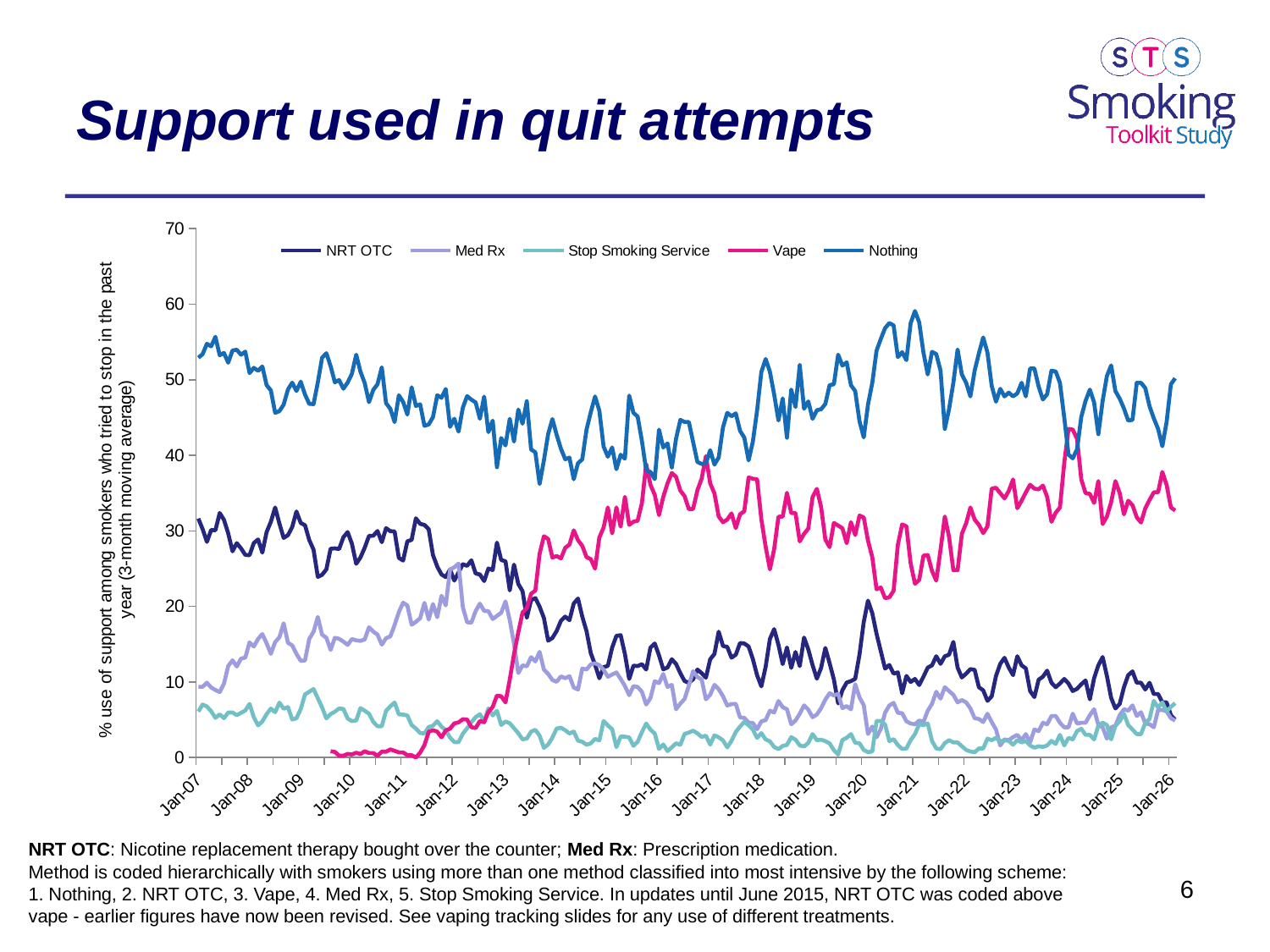
Which series has the lowest value around Jan-20? Stop Smoking Service Is the value for Vape at Jan-10 greater or less than 10? less Does the NRT OTC series rise or fall overall from Jan-07 to Jan-26? fall Is the value for NRT OTC at Jan-07 greater or less than 40? less Which series is drawn in pink? Vape Does the Vape series rise or fall overall from Jan-10 to Jan-16? rise How many series does the legend list? 5 What kind of chart is shown on the slide? line chart At Jan-26, which is larger, Vape or NRT OTC? Vape Which series has the highest values for most of the period shown? Nothing How many year labels are shown on the x axis? 20 Is the value for Nothing at Jan-07 greater or less than 50? greater